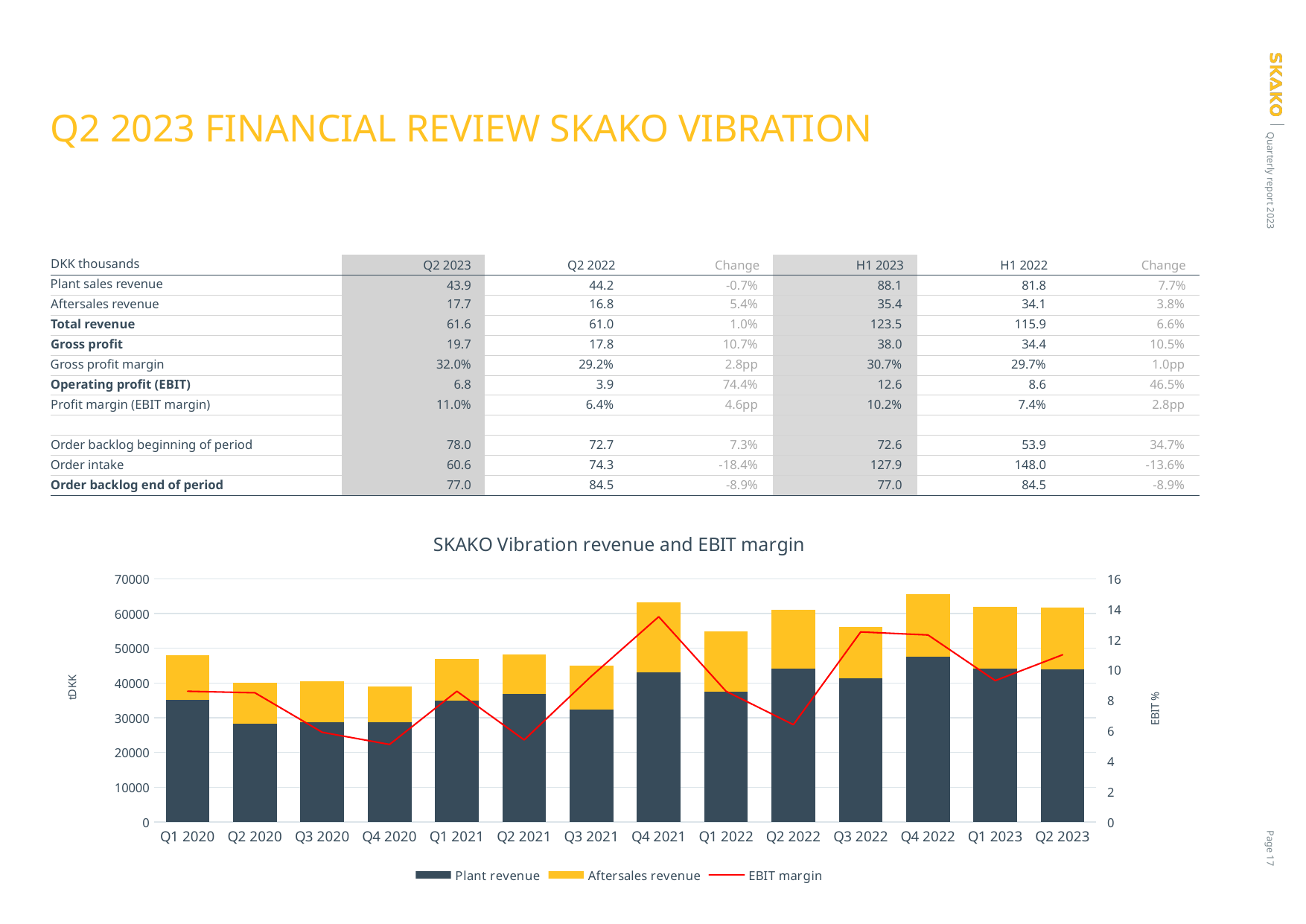
In which quarter does the EBIT margin line reach its highest point? Q4 2021 Is the total revenue bar for Q3 2020 greater or less than 50000? less What kind of chart is shown on the slide? Stacked bar chart with a line What label is shown on the right-hand vertical axis of the chart? EBIT % Does the EBIT margin line rise or fall from Q4 2021 to Q2 2022? fall How many series does the chart legend list? 3 What is the title of the chart? SKAKO Vibration revenue and EBIT margin Is the EBIT margin for Q2 2022 greater or less than 8? less Which quarter has the larger total revenue bar, Q4 2021 or Q1 2022? Q4 2021 Is the total revenue bar for Q4 2022 greater or less than 60000? greater How many quarters are plotted on the x axis of the chart? 14 Which quarter has the highest total revenue bar in the chart? Q4 2022